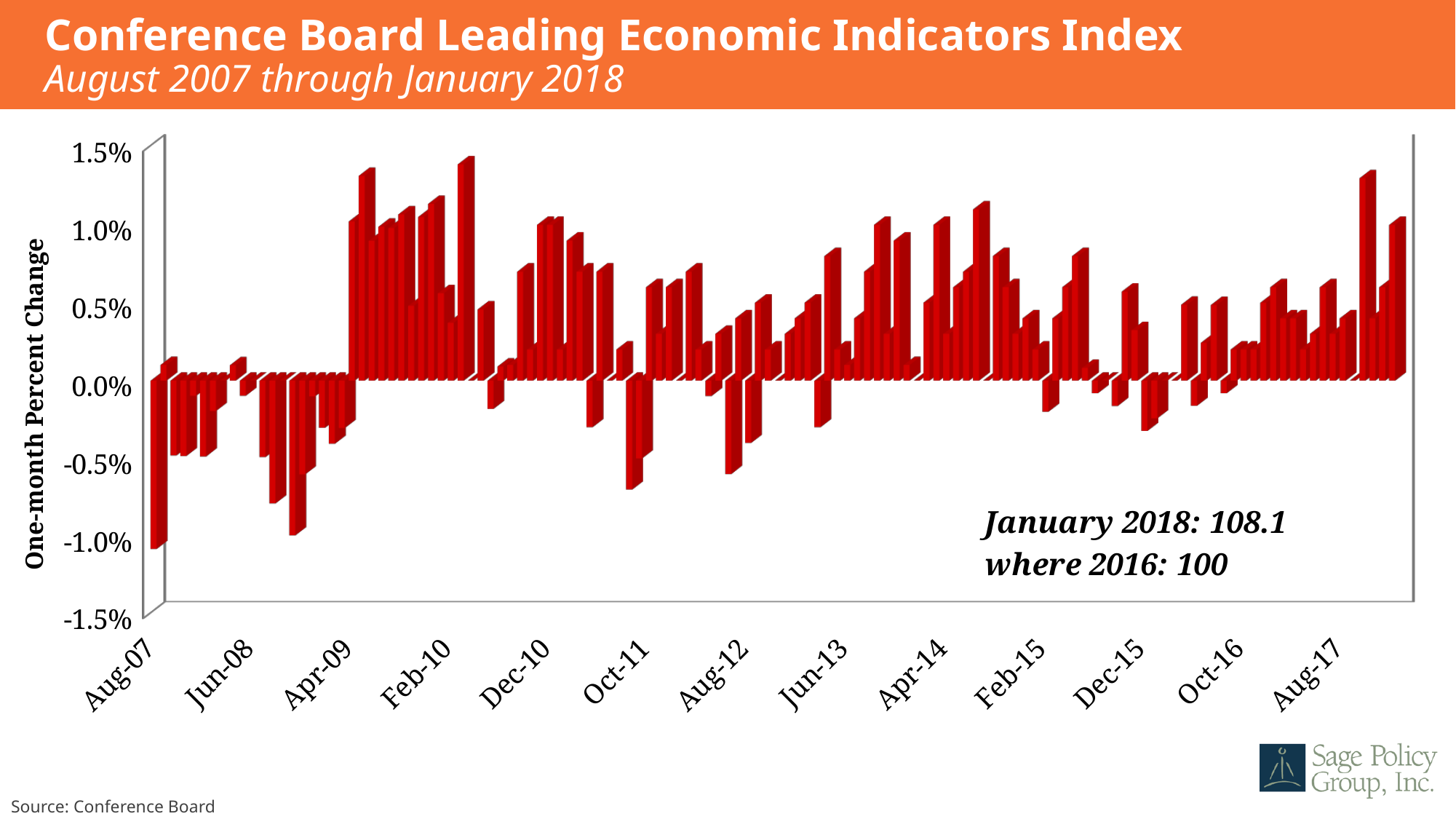
Is the value for Aug-07 positive or negative? negative What is the source cited for the chart data? Conference Board What is the title of the chart? Conference Board Leading Economic Indicators Index Is the value for Aug-07 greater or less than -0.5%? less According to the annotation on the chart, what was the index value in January 2018? 108.1 What is the label on the vertical axis? One-month Percent Change What is the lowest value shown on the vertical axis? -1.5% How many month labels are shown along the horizontal axis? 13 What period does the chart cover, according to the subtitle? August 2007 through January 2018 What kind of chart is shown on the slide? Bar chart What is the highest value shown on the vertical axis? 1.5%